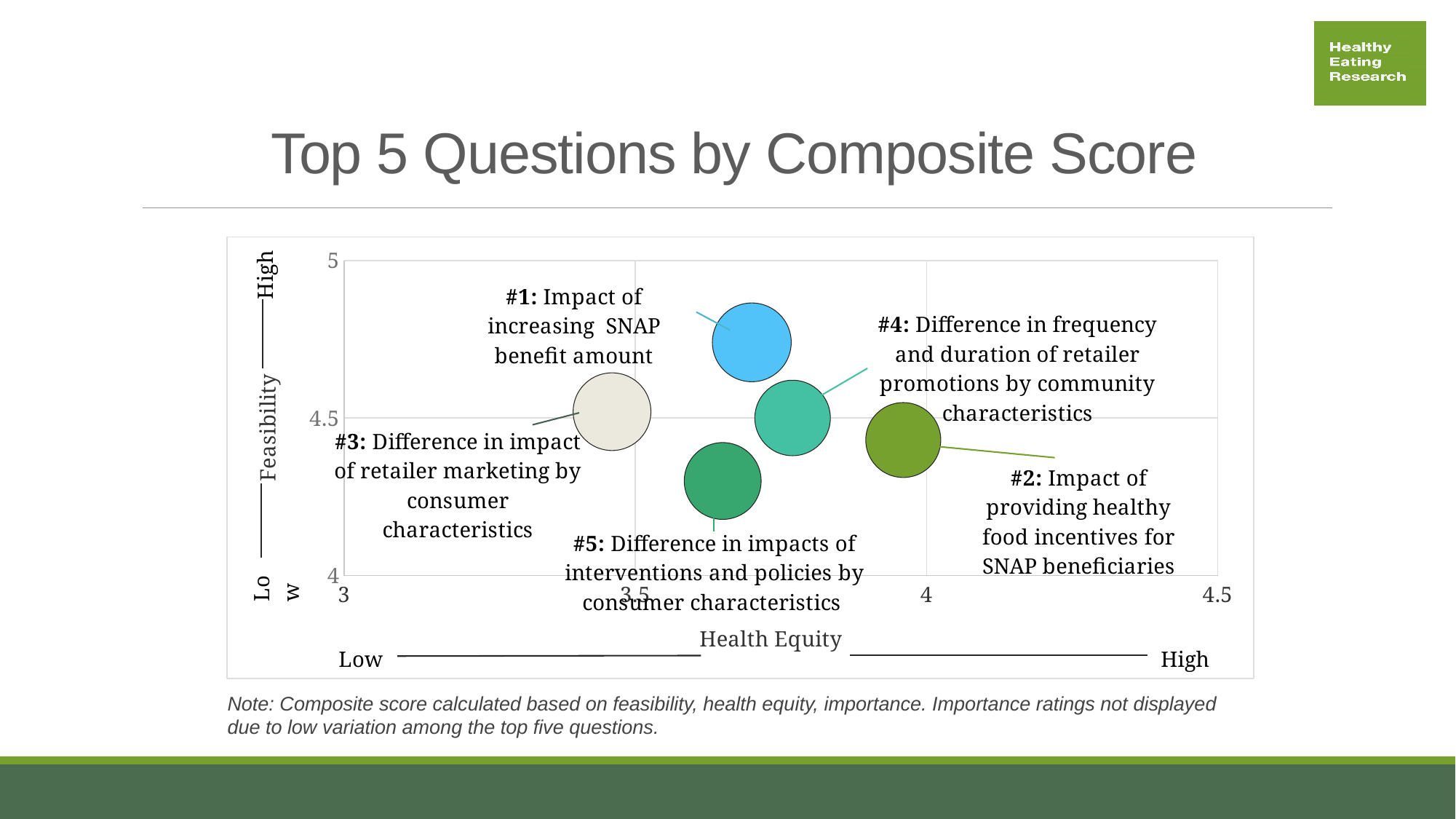
Which question has the highest feasibility score? #1: Impact of increasing SNAP benefit amount Which has the higher feasibility score, question #1 or question #5? Question #1 Which question has the lowest health equity score? #3: Difference in impact of retailer marketing by consumer characteristics Which question has the lowest feasibility score? #5: Difference in impacts of interventions and policies by consumer characteristics What does the horizontal axis of the chart represent? Health Equity What kind of chart is shown on the slide? Bubble chart Is the health equity score for question #2 greater or less than 3.5? greater Which question has the highest health equity score? #2: Impact of providing healthy food incentives for SNAP beneficiaries Is the feasibility score for question #5 greater or less than 4.5? less Is the feasibility score for question #1 greater or less than 4.5? greater How many questions (bubbles) are plotted on the chart? 5 What is the title of the chart on the slide? Top 5 Questions by Composite Score